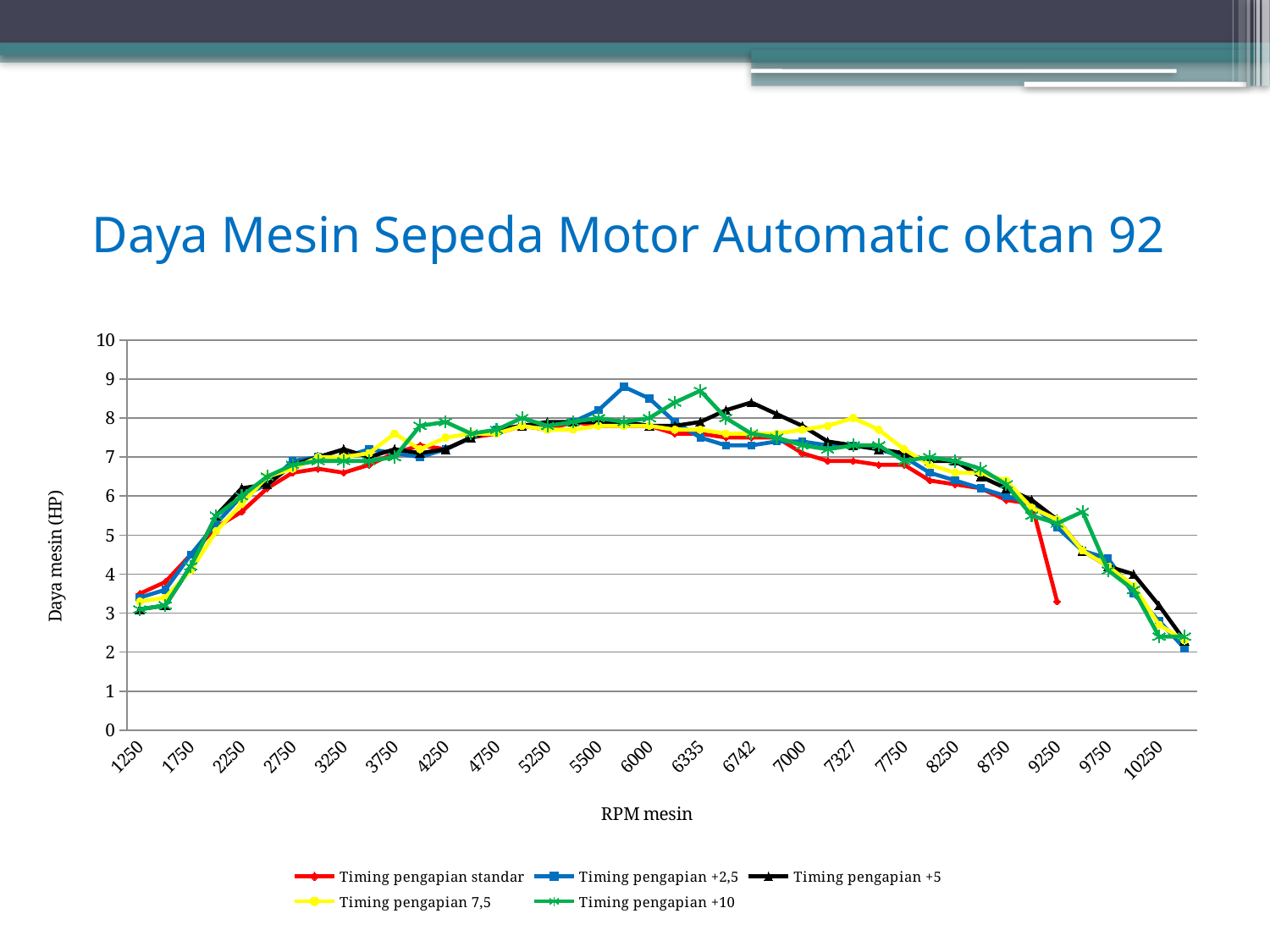
What is the title of the chart? Daya Mesin Sepeda Motor Automatic oktan 92 At 9250 RPM, which is larger: Timing pengapian standar or Timing pengapian +5? Timing pengapian +5 Is the value for Timing pengapian standar at 9250 RPM greater or less than 4? less Which series has the highest value at 6000 RPM? Timing pengapian +2,5 Is the value for Timing pengapian +5 at 6742 RPM greater or less than 8? greater Is the value for Timing pengapian +2,5 at 6000 RPM greater or less than 8? greater What kind of chart is shown on the slide? line chart Which series has the highest value at 6335 RPM? Timing pengapian +10 Do the values for Timing pengapian +5 rise or fall from 8750 RPM to 10250 RPM? fall Which series has the highest value at 6742 RPM? Timing pengapian +5 How many series does the legend list? 5 What is the label of the vertical axis? Daya mesin (HP)